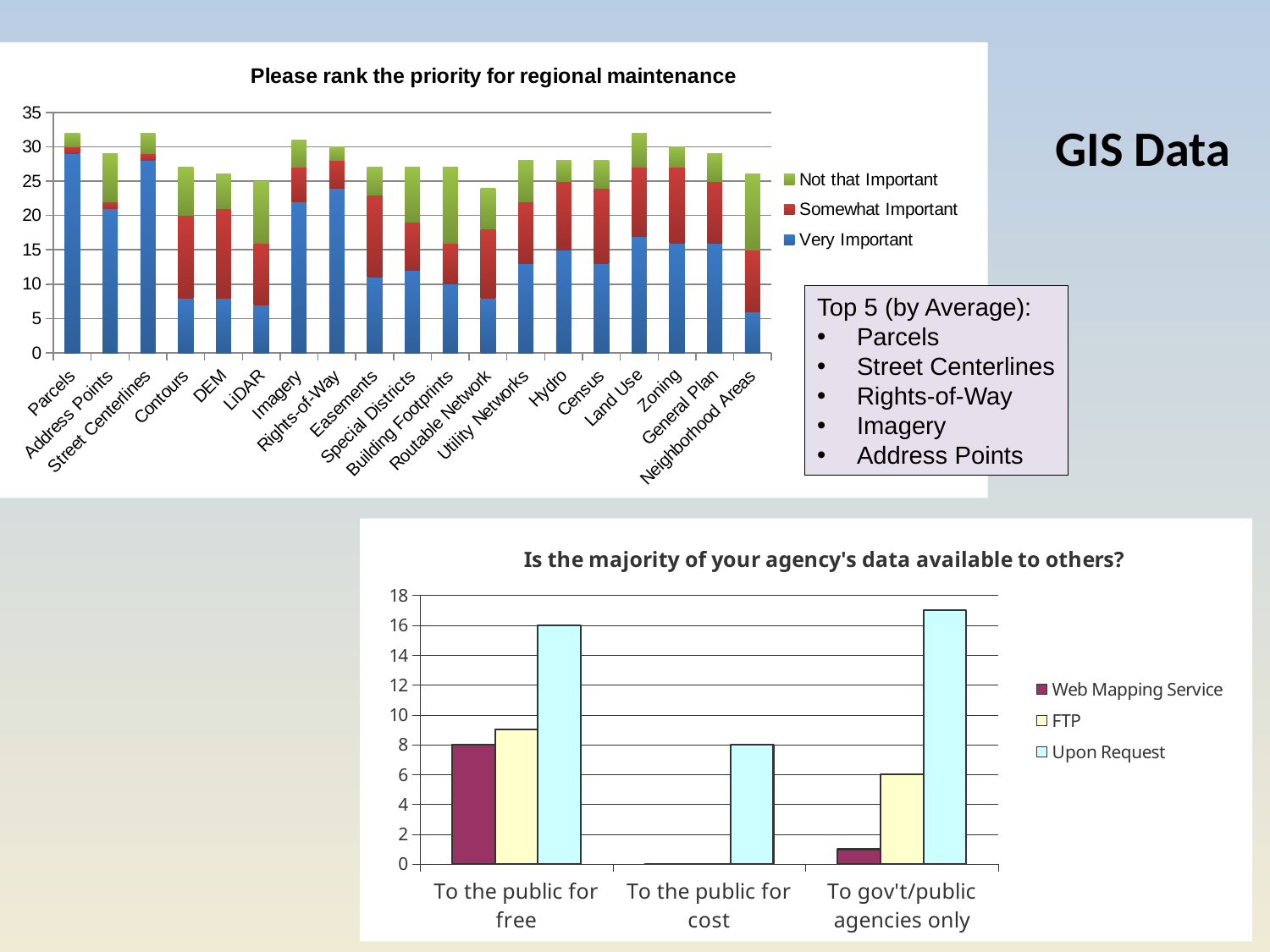
What type of chart is the top chart titled 'Please rank the priority for regional maintenance'? Stacked bar chart In the top chart 'Please rank the priority for regional maintenance', which series is shown in blue? Very Important In the bottom chart 'Is the majority of your agency's data available to others?', what is the value for Web Mapping Service in 'To the public for free'? 8 How many series does the legend of the top chart 'Please rank the priority for regional maintenance' list? 3 In the top chart 'Please rank the priority for regional maintenance', is the total stacked value for Neighborhood Areas greater or less than 30? less In the bottom chart 'Is the majority of your agency's data available to others?', which is larger: Upon Request for 'To the public for free' or Upon Request for 'To the public for cost'? To the public for free How many categories are shown on the x axis of the top chart 'Please rank the priority for regional maintenance'? 19 In the top chart 'Please rank the priority for regional maintenance', is the total stacked value for Parcels greater or less than 30? greater In the bottom chart 'Is the majority of your agency's data available to others?', what is the value for Upon Request in 'To the public for free'? 16 In the bottom chart 'Is the majority of your agency's data available to others?', what is the difference between Upon Request and Web Mapping Service for 'To the public for free'? 8 What is the title of the bottom chart? Is the majority of your agency's data available to others? In the top chart 'Please rank the priority for regional maintenance', is the 'Very Important' value for Contours greater or less than 10? less